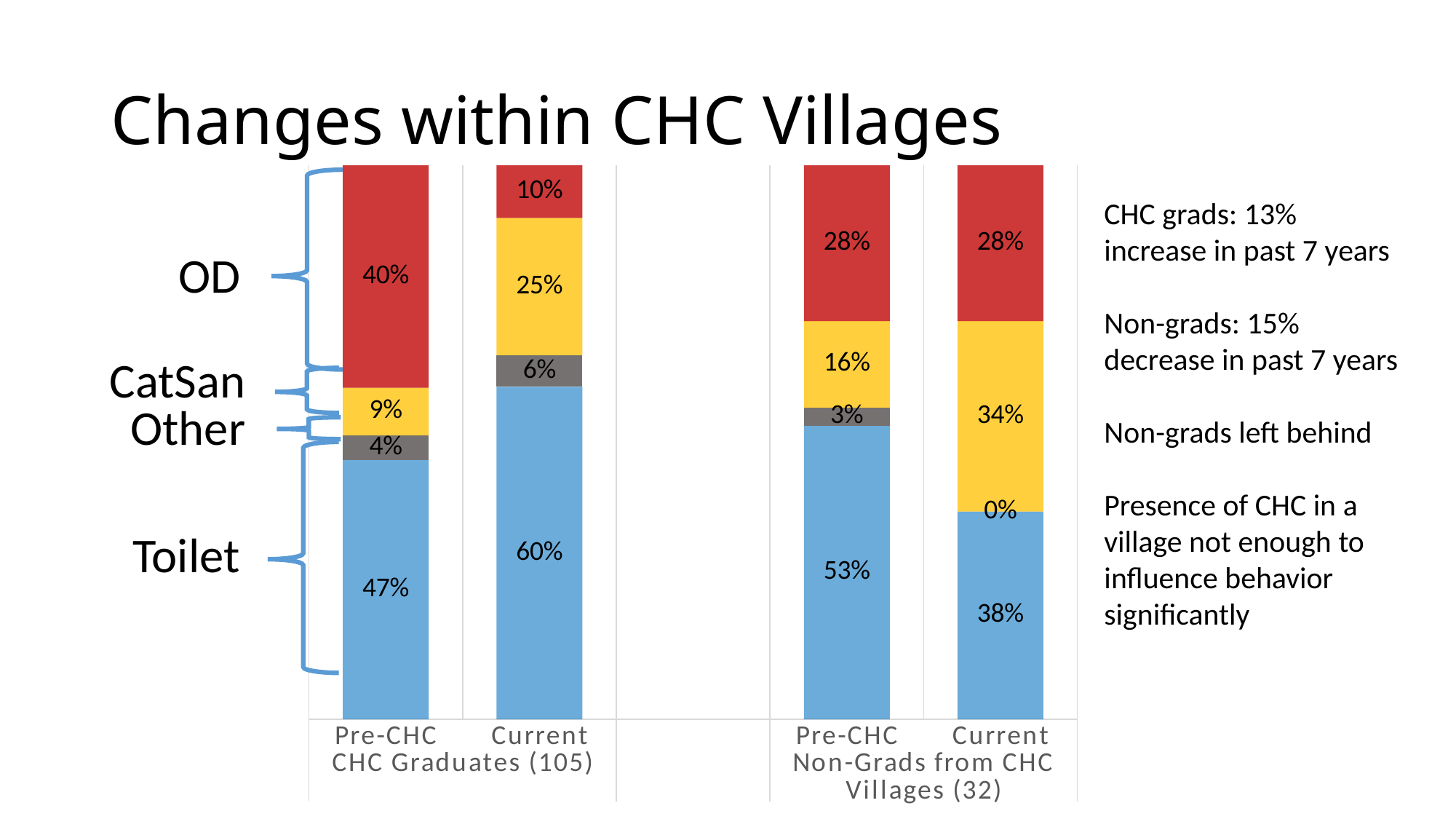
By how many percentage points did the Toilet share for CHC Graduates change from Pre-CHC to Current? 13 percentage points What percentage of the Current bar for CHC Graduates (105) is Toilet? 60% What kind of chart is shown on the slide? Stacked bar chart What is the Other share in the Current bar for Non-Grads from CHC Villages (32)? 0% By how many percentage points did the Toilet share for Non-Grads from CHC Villages change from Pre-CHC to Current? 15 percentage points What is the title of the slide? Changes within CHC Villages Which has a larger OD share: the Pre-CHC bar for CHC Graduates or the Pre-CHC bar for Non-Grads? Pre-CHC CHC Graduates Which bar has the highest Toilet share? Current, CHC Graduates (105) How many stacked bars are shown in the chart? 4 What is the CatSan share in the Current bar for Non-Grads from CHC Villages (32)? 34% What is the OD share in the Pre-CHC bar for CHC Graduates (105)? 40% Which bar has the lowest Toilet share? Current, Non-Grads from CHC Villages (32)